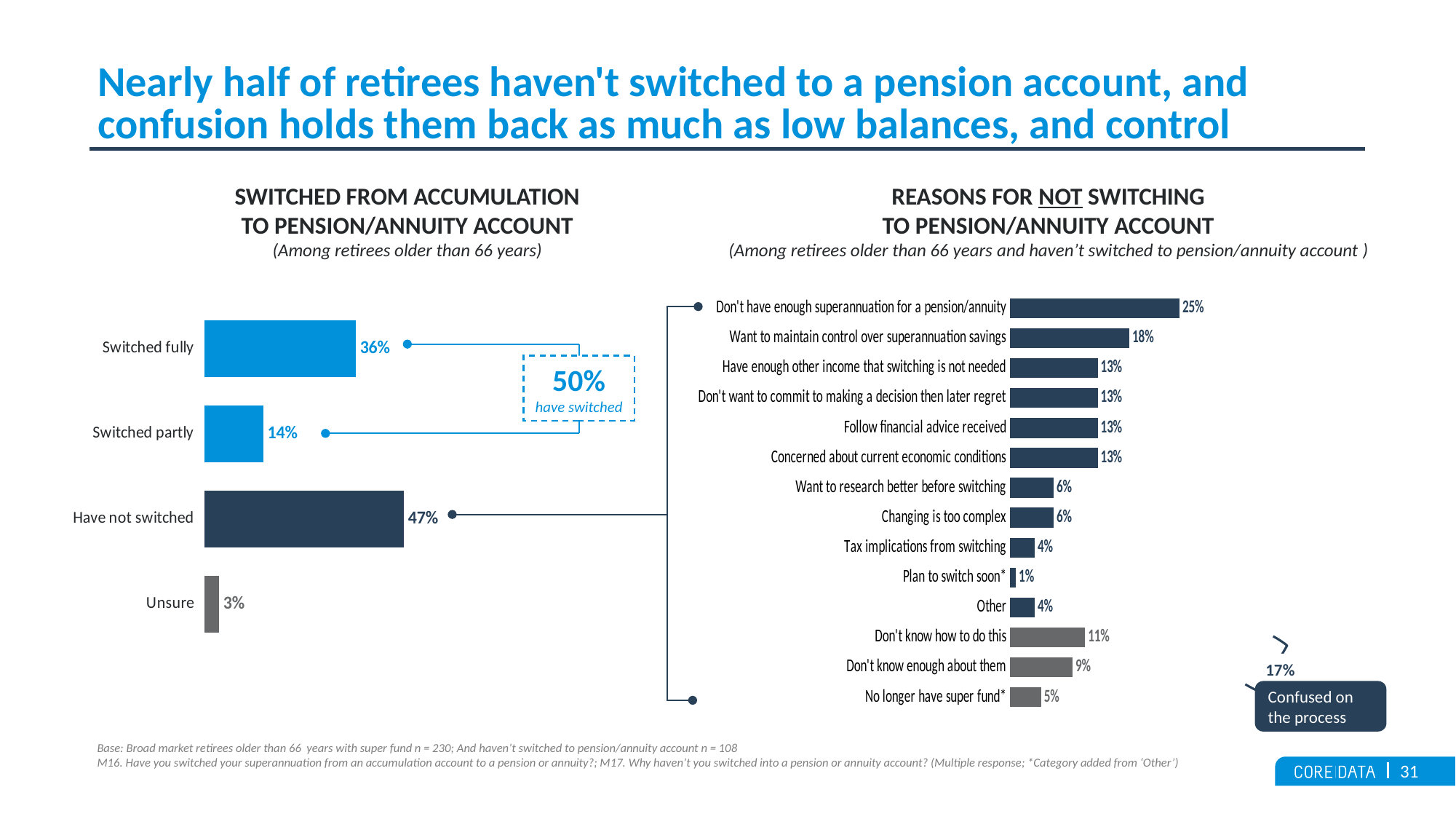
In the 'Switched from accumulation to pension/annuity account' chart, what percentage switched partly? 14% In the 'Switched from accumulation to pension/annuity account' chart, what percentage of retirees have not switched? 47% In the 'Switched from accumulation to pension/annuity account' chart, what is the difference between 'Have not switched' and 'Switched fully'? 11% In the 'Reasons for not switching to pension/annuity account' chart, which reason has the lowest value? Plan to switch soon* In the 'Reasons for not switching to pension/annuity account' chart, what is the value for 'Want to maintain control over superannuation savings'? 18% In the 'Reasons for not switching to pension/annuity account' chart, which reason has the highest value? Don't have enough superannuation for a pension/annuity In the 'Reasons for not switching to pension/annuity account' chart, which is larger: 'Don't know enough about them' or 'No longer have super fund*'? Don't know enough about them In the 'Reasons for not switching to pension/annuity account' chart, how many reasons are listed? 14 In the 'Switched from accumulation to pension/annuity account' chart, which category has the lowest value? Unsure In the 'Switched from accumulation to pension/annuity account' chart, how many categories are shown? 4 What type of chart is the 'Reasons for not switching to pension/annuity account' chart? Bar chart In the 'Reasons for not switching to pension/annuity account' chart, what is the value for 'Don't know how to do this'? 11%